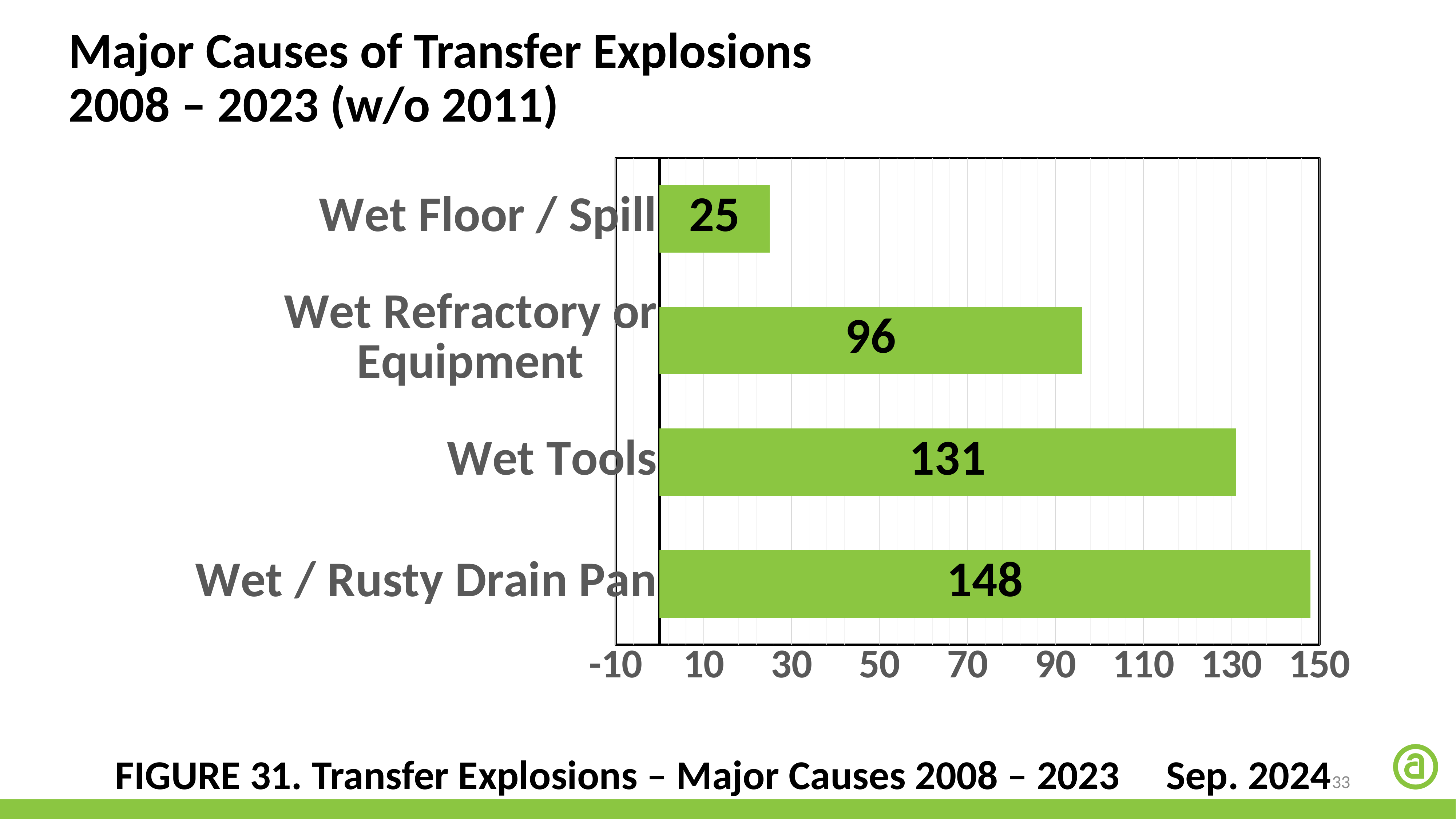
Which cause has the lowest value? Wet Floor / Spill How many causes are shown in the chart? 4 What kind of chart is shown on the slide? bar chart Which is larger, the value for Wet Tools or the value for Wet Refractory or Equipment? Wet Tools What is the difference between the values for Wet / Rusty Drain Pan and Wet Tools? 17 What is the difference between the values for Wet Tools and Wet Refractory or Equipment? 35 What is the value for Wet Floor / Spill? 25 What is the value for Wet Tools? 131 Which cause has the highest value? Wet / Rusty Drain Pan Is the value for Wet Refractory or Equipment greater or less than 110? less What is the value for Wet Refractory or Equipment? 96 What is the value for Wet / Rusty Drain Pan? 148